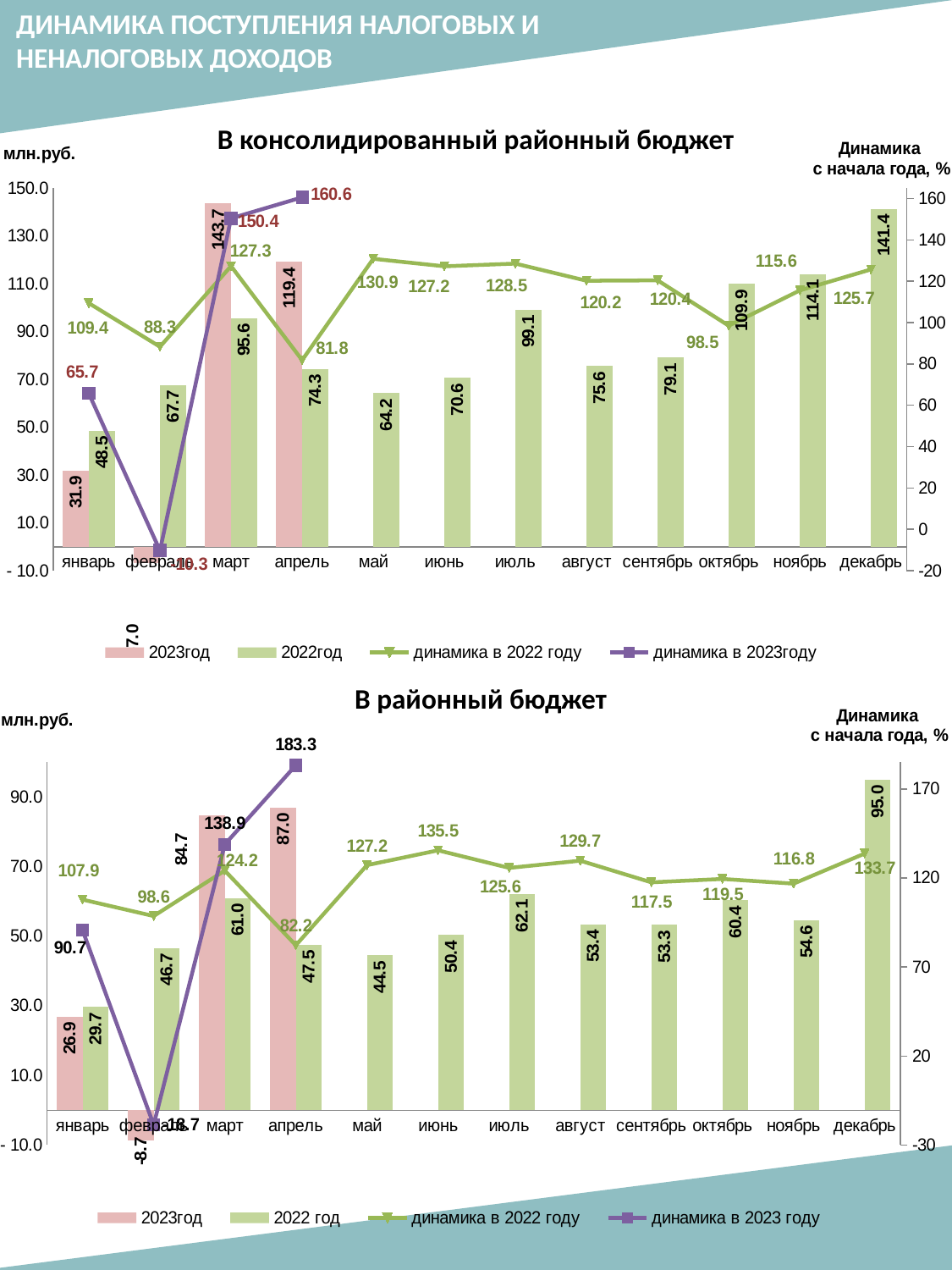
In the chart 'В консолидированный районный бюджет', what is the 2023 год value for март? 143.7 In the chart 'В консолидированный районный бюджет', what is the 2022 год value for декабрь? 141.4 In the chart 'В районный бюджет', which is larger for апрель: the 2023 год bar or the 2022 год bar? 2023 год In the chart 'В консолидированный районный бюджет', what is the difference between the 2023 год and 2022 год values for март? 48.1 In the chart 'В консолидированный районный бюджет', which month has the lowest 2022 год bar? январь In the chart 'В консолидированный районный бюджет', how many series does the legend list? 4 In the chart 'В районный бюджет', what is the value of 'динамика в 2023 году' for апрель? 183.3 In the chart 'В районный бюджет', what is the value of 'динамика в 2022 году' for июнь? 135.5 How many months are shown on the x axis of the chart 'В районный бюджет'? 12 In the chart 'В консолидированный районный бюджет', what is the value of 'динамика в 2023 году' for апрель? 160.6 In the chart 'В районный бюджет', which month has the highest 2022 год bar? декабрь In the chart 'В районный бюджет', what is the 2022 год value for июль? 62.1